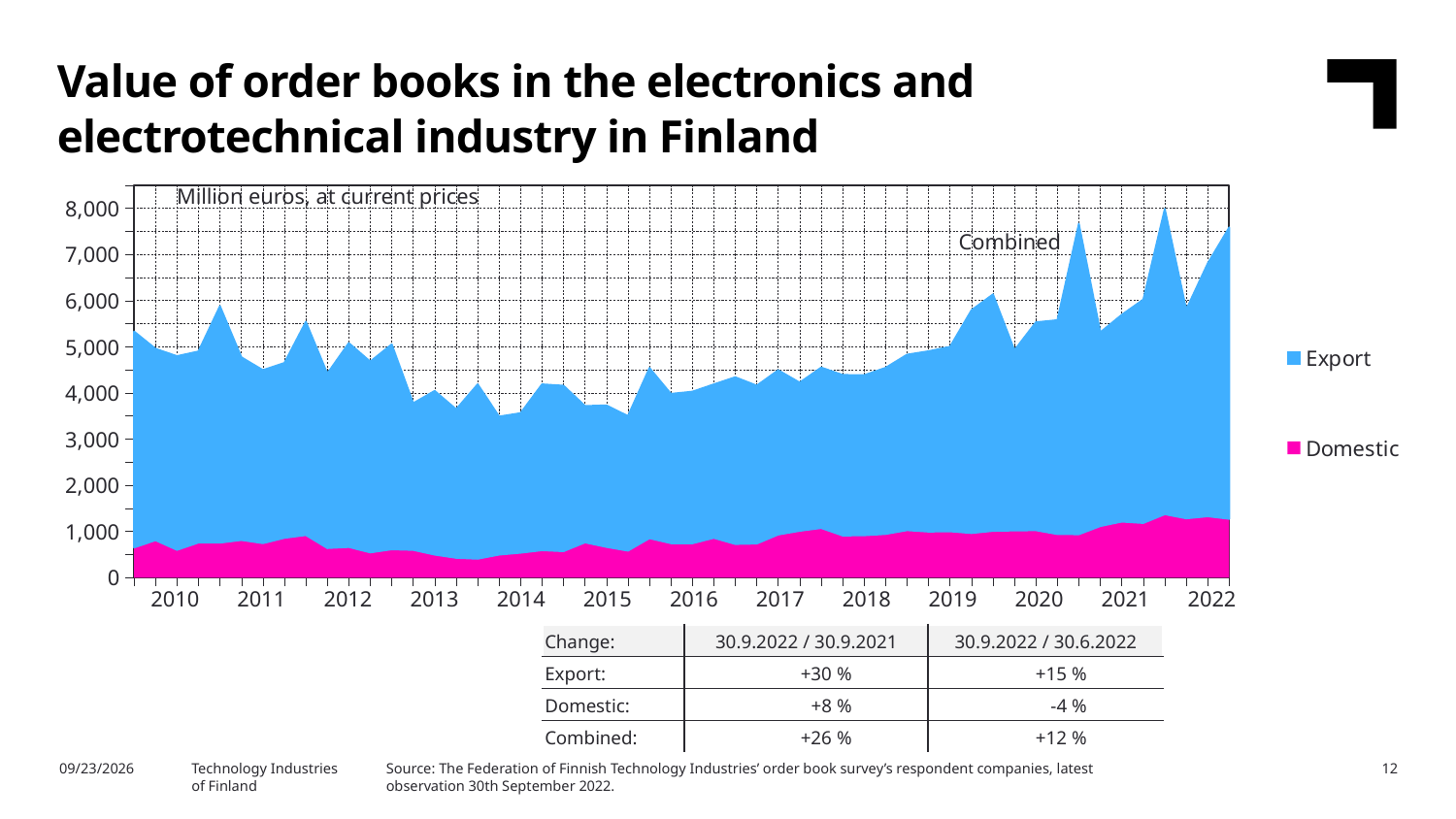
According to the table, what is the Export change for 30.9.2022 / 30.9.2021? +30 % According to the table, what is the Domestic change for 30.9.2022 / 30.6.2022? -4 % Is the Domestic value at the end of 2022 greater or less than 1,000? greater Is the combined value of order books at the end of 2022 greater or less than 7,000? greater What unit is the chart measured in, according to the label inside the plot area? Million euros, at current prices Which series is larger throughout the chart, Export or Domestic? Export How many series does the chart legend list? 2 According to the table, what is the Combined change for 30.9.2022 / 30.9.2021? +26 % Does the combined value of order books rise or fall from 2019 to 2022? rise Which two series are listed in the chart legend? Export and Domestic What kind of chart is shown on the slide? Stacked area chart